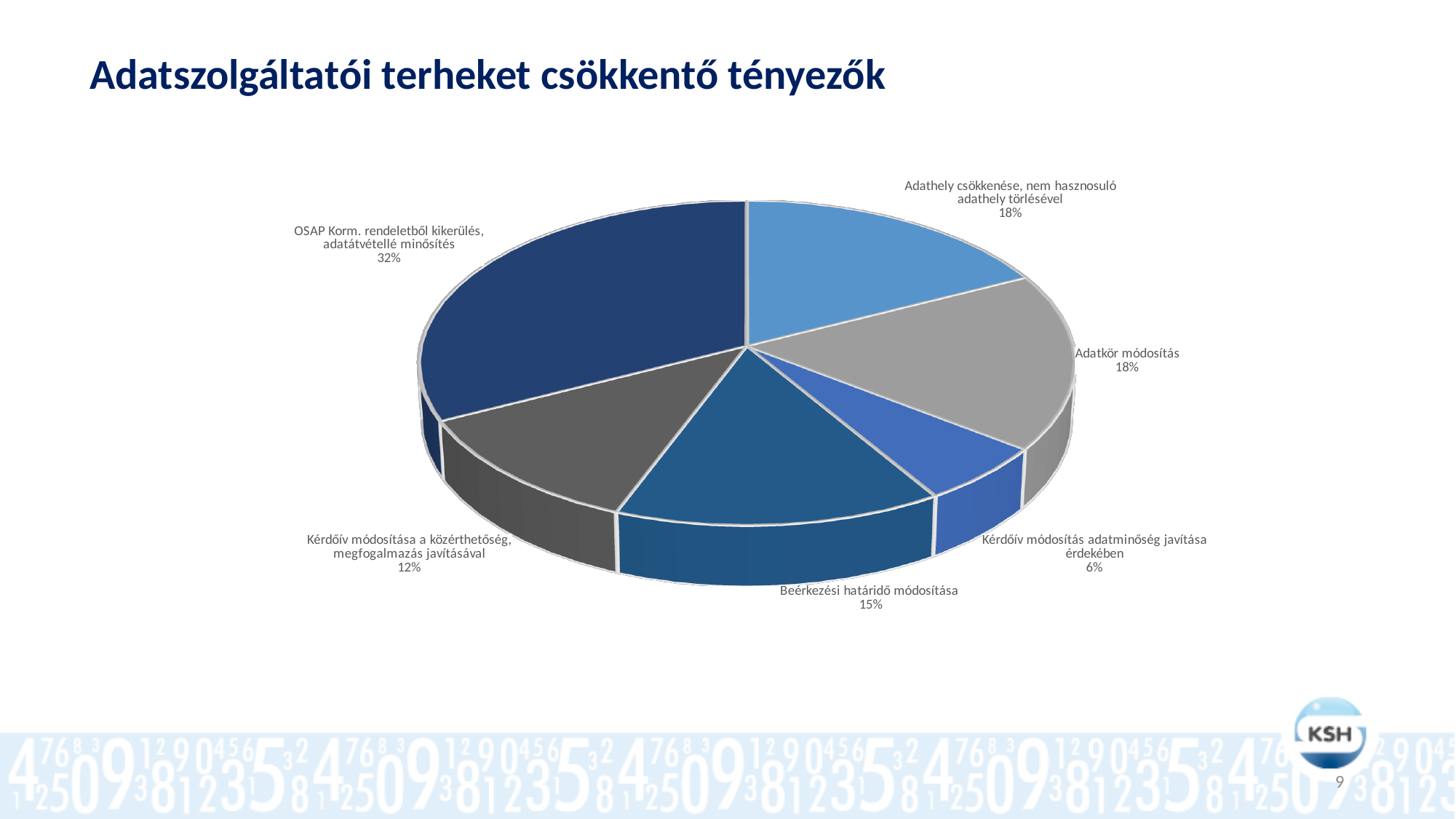
What is the title of the slide? Adatszolgáltatói terheket csökkentő tényezők What is the difference in percentage points between "OSAP Korm. rendeletből kikerülés, adatátvétellé minősítés" and "Beérkezési határidő módosítása"? 17 percentage points What percentage is shown for "Adatkör módosítás"? 18% What percentage is shown for "Beérkezési határidő módosítása"? 15% What type of chart is shown on the slide? Pie chart What share of the pie does "OSAP Korm. rendeletből kikerülés, adatátvétellé minősítés" represent? 32% Which category has the largest share of the pie? OSAP Korm. rendeletből kikerülés, adatátvétellé minősítés Which category has the smallest share of the pie? Kérdőív módosítás adatminőség javítása érdekében How many slices does the pie chart have? 6 What percentage is shown for "Kérdőív módosítás adatminőség javítása érdekében"? 6% Which is larger: the share for "Beérkezési határidő módosítása" or for "Kérdőív módosítása a közérthetőség, megfogalmazás javításával"? Beérkezési határidő módosítása What is the combined share of "Adathely csökkenése, nem hasznosuló adathely törlésével" and "Adatkör módosítás"? 36%